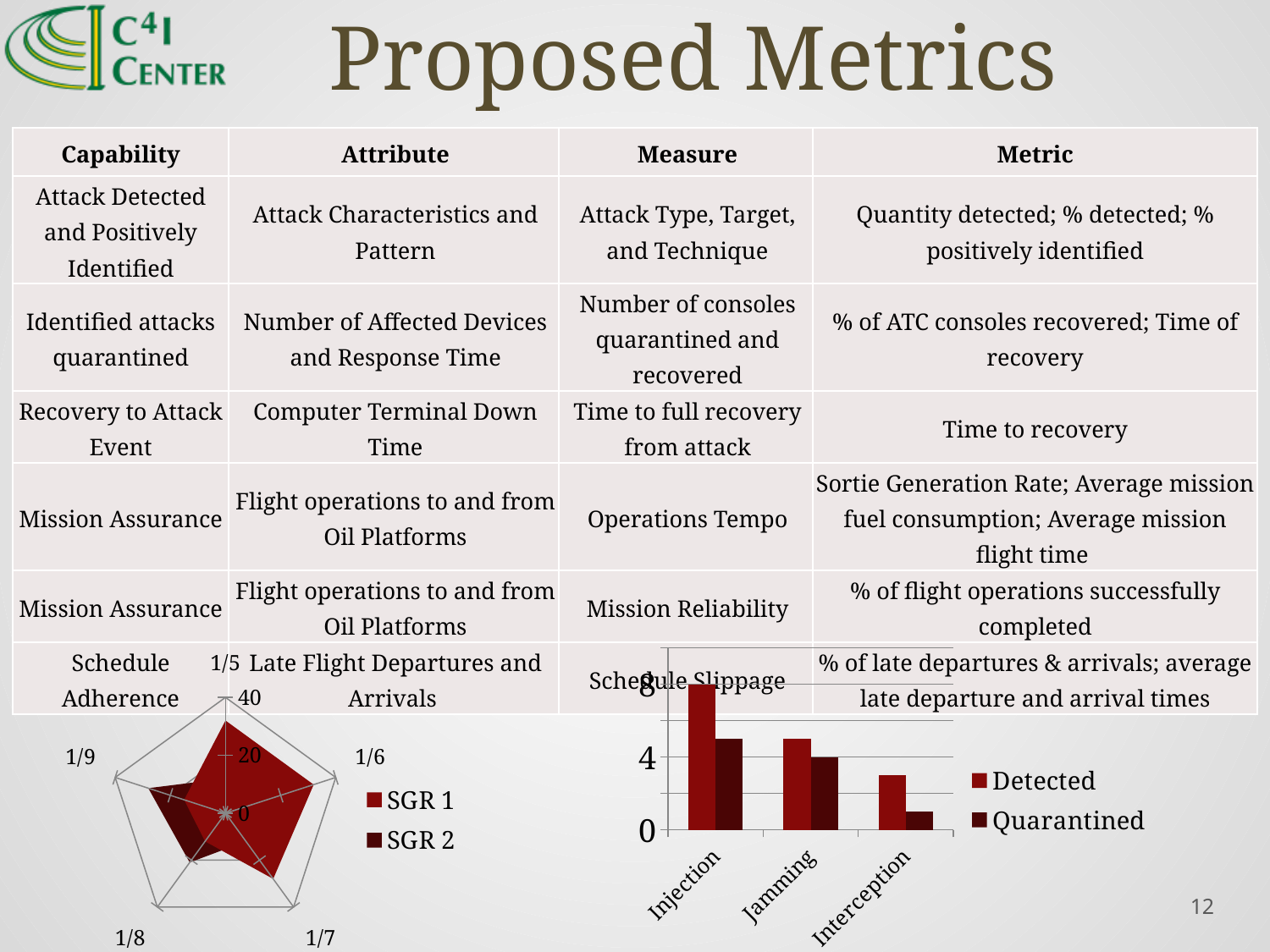
In the bar chart on the bottom right, which category has the highest Detected value? Injection In the radar chart on the bottom left, how many categories are shown around the chart? 5 What kind of chart is the chart on the bottom left of the slide? radar chart In the bar chart on the bottom right, which is larger for Injection: Detected or Quarantined? Detected In the bar chart on the bottom right, which category has the lowest Quarantined value? Interception In the radar chart on the bottom left, how many series does the legend list? 2 In the bar chart on the bottom right, is the Detected value for Injection greater or less than 4? greater What kind of chart is the chart on the bottom right of the slide? bar chart In the bar chart on the bottom right, how many categories are shown on the x axis? 3 In the bar chart on the bottom right, how many series does the legend list? 2 In the bar chart on the bottom right, do the Detected values rise or fall from Injection to Interception? fall In the bar chart on the bottom right, is the Quarantined value for Interception greater or less than 4? less